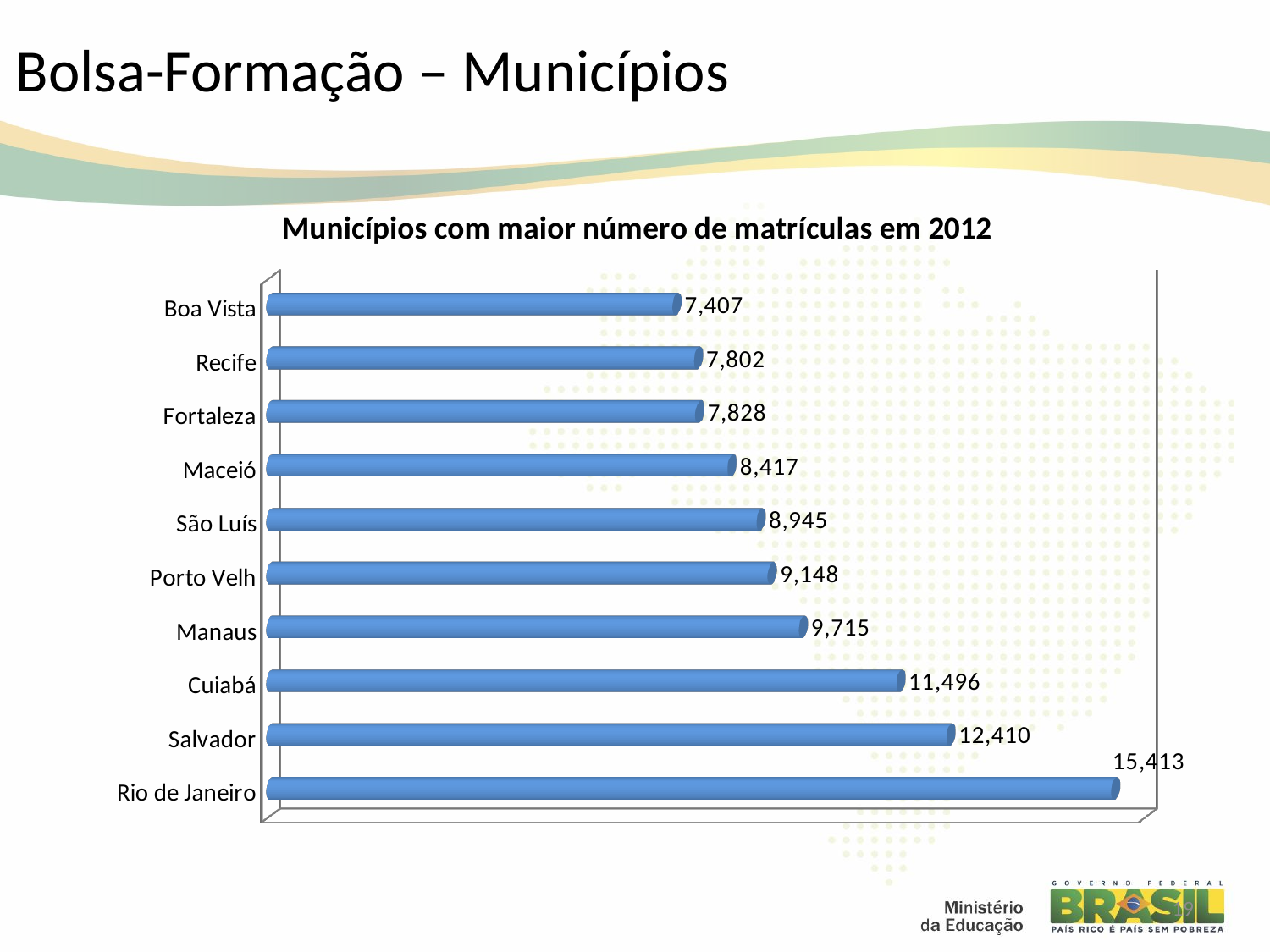
Which municipality has the lowest number of enrolments? Boa Vista What kind of chart is shown on the slide? Bar chart How many municipalities are shown in the chart? 10 What is the value for Maceió? 8,417 What is the difference between the values for Rio de Janeiro and Boa Vista? 8,006 What colour are the bars in the chart? Blue Which is larger, the value for Manaus or the value for Porto Velh? Manaus What is the value for Rio de Janeiro? 15,413 What is the value for Cuiabá? 11,496 What is the title of the chart? Municípios com maior número de matrículas em 2012 What is the difference between the values for Salvador and Cuiabá? 914 Which municipality has the highest number of enrolments? Rio de Janeiro